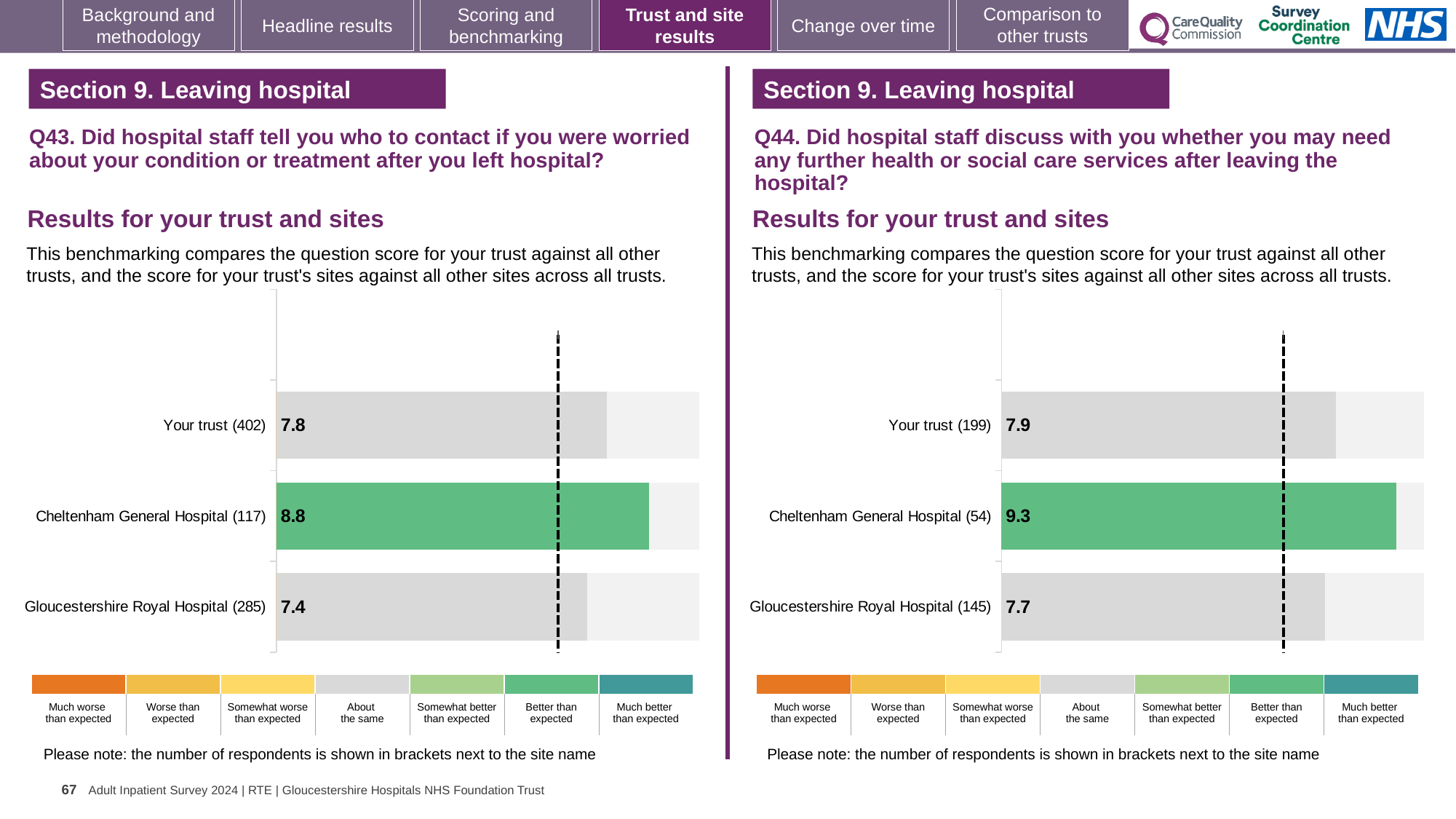
On the Q43 chart (left), what is the difference between the scores for Cheltenham General Hospital and Gloucestershire Royal Hospital? 1.4 On the Q43 chart (left), which site or trust has the lowest score? Gloucestershire Royal Hospital On the Q44 chart (right), which has the larger score, Your trust or Gloucestershire Royal Hospital? Your trust On the Q44 chart (right), what is the score for Gloucestershire Royal Hospital? 7.7 On the Q44 chart (right), what is the difference between the scores for Cheltenham General Hospital and Your trust? 1.4 On the Q44 chart (right), what is the score for Cheltenham General Hospital? 9.3 On the Q43 chart (left), what is the score for Cheltenham General Hospital? 8.8 On the Q44 chart (right), which site or trust has the highest score? Cheltenham General Hospital On the Q43 chart (left), what is the score for Your trust? 7.8 How many bars are plotted on the Q43 chart (left)? 3 What kind of chart is used on the Q44 chart (right)? Bar chart On the Q43 chart (left), what is the score for Gloucestershire Royal Hospital? 7.4